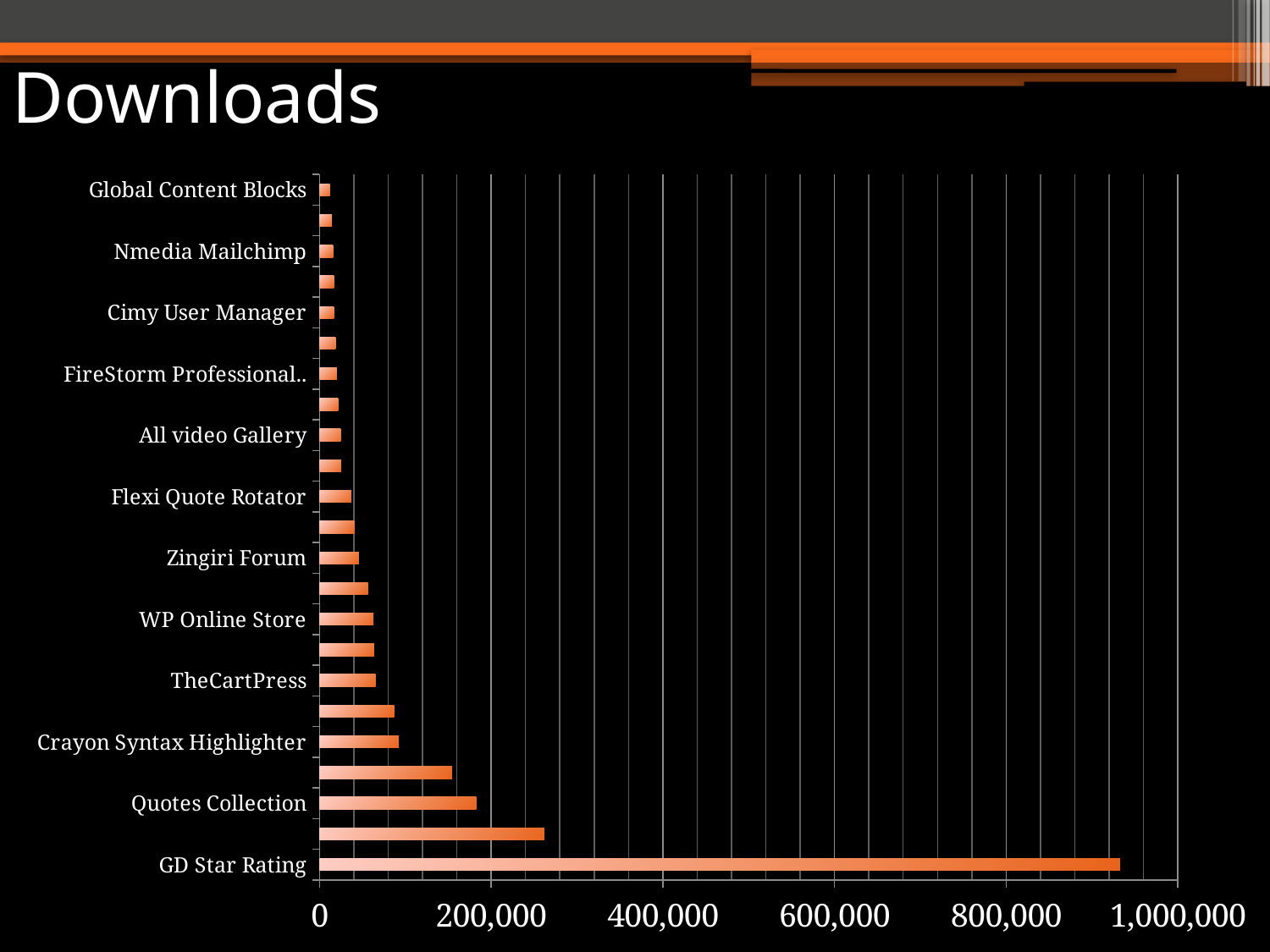
Is the value for GD Star Rating greater or less than 1,000,000? less What is the title of the slide? Downloads Is the value for GD Star Rating greater or less than 800,000? greater Is the value for Crayon Syntax Highlighter greater or less than 200,000? less What kind of chart is shown on the slide? bar chart Which is larger, the value for Quotes Collection or the value for Crayon Syntax Highlighter? Quotes Collection Which of the labeled categories has the lowest value? Global Content Blocks Which category has the highest value? GD Star Rating Which is larger, the value for GD Star Rating or the value for Quotes Collection? GD Star Rating What is the highest value shown on the horizontal axis? 1,000,000 How many category labels are shown on the vertical axis? 12